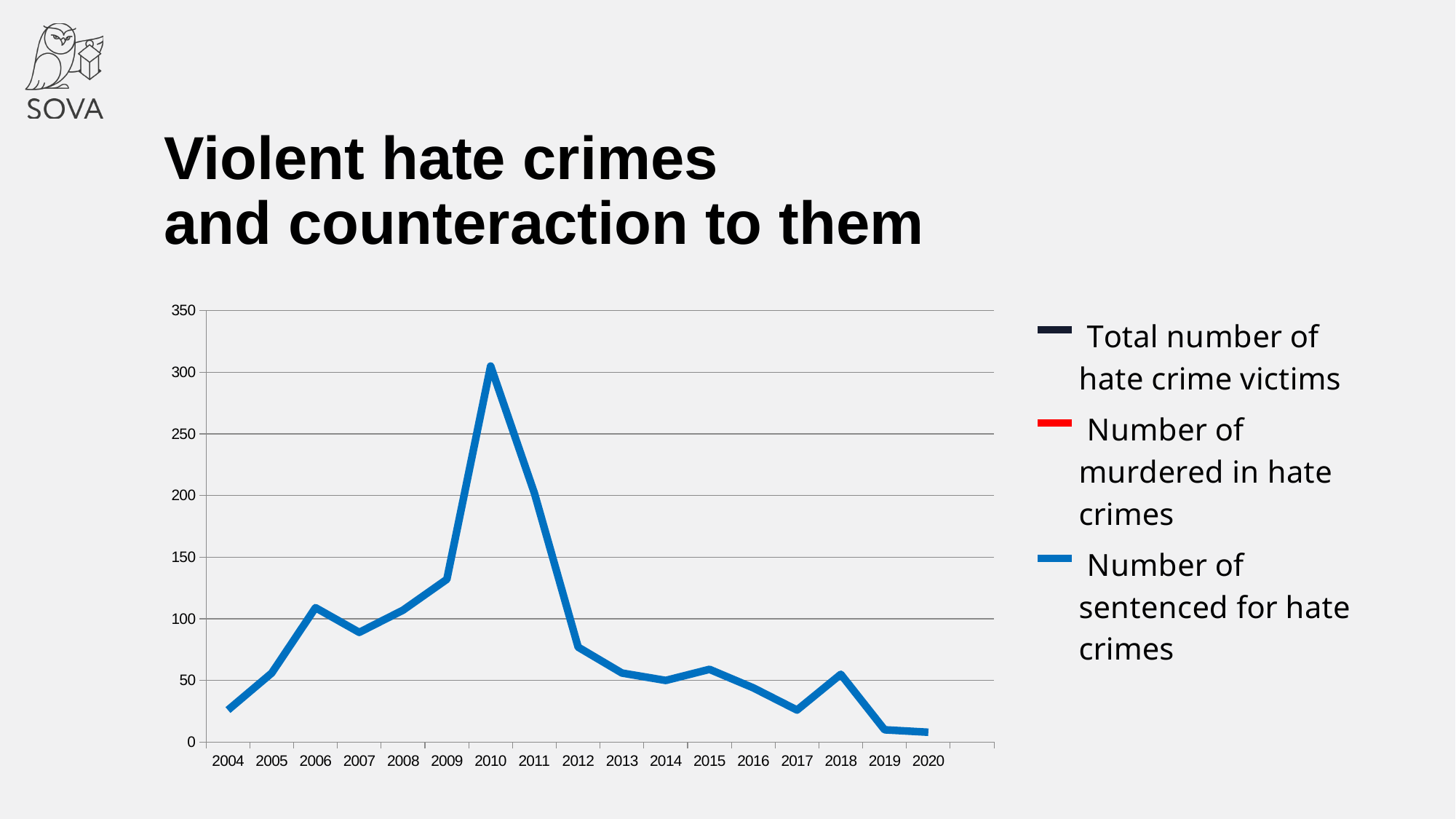
Does the 'Number of sentenced for hate crimes' line rise or fall from 2010 to 2012? fall What kind of chart is shown on the slide? line chart In which year does the 'Number of sentenced for hate crimes' line reach its highest value? 2010 Which year has the larger value for 'Number of sentenced for hate crimes', 2006 or 2007? 2006 Is the value for 'Number of sentenced for hate crimes' in 2017 greater or less than 50? less How many years are shown along the x axis? 17 How many series does the legend list? 3 What colour is the line for 'Number of sentenced for hate crimes'? blue Is the value for 'Number of sentenced for hate crimes' in 2004 greater or less than 50? less Is the value for 'Number of sentenced for hate crimes' in 2006 greater or less than 100? greater Which year has the larger value for 'Number of sentenced for hate crimes', 2009 or 2011? 2011